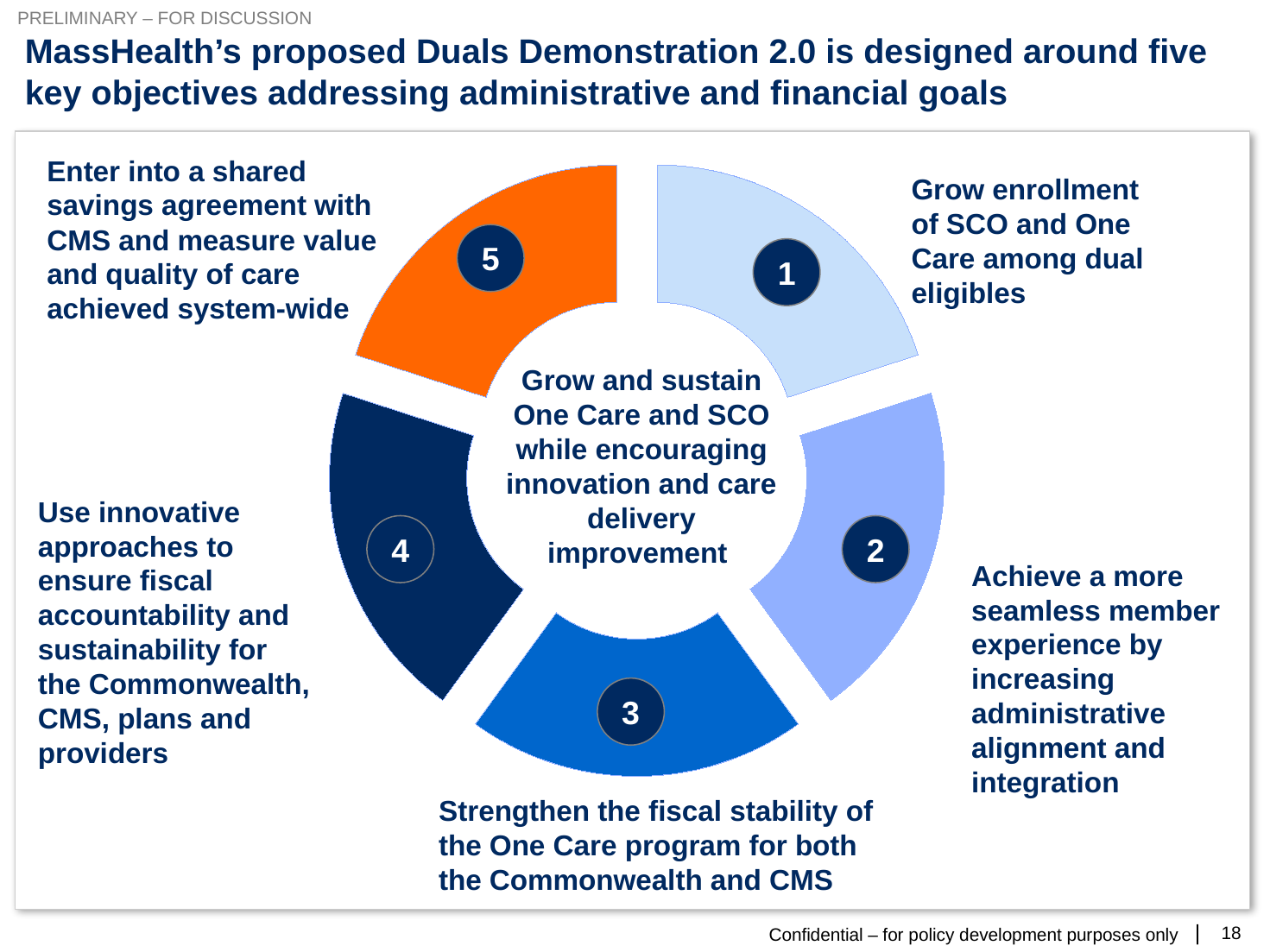
Which segment number is associated with the objective about entering into a shared savings agreement with CMS? 5 Which segment number is associated with the objective 'Use innovative approaches to ensure fiscal accountability and sustainability for the Commonwealth, CMS, plans and providers'? 4 What text appears in the center of the ring diagram? Grow and sustain One Care and SCO while encouraging innovation and care delivery improvement What objective is associated with segment 1 of the ring diagram? Grow enrollment of SCO and One Care among dual eligibles Which segment number is associated with the objective 'Achieve a more seamless member experience by increasing administrative alignment and integration'? 2 How many numbered segments does the ring diagram on the slide contain? 5 What objective is associated with segment 3 of the ring diagram? Strengthen the fiscal stability of the One Care program for both the Commonwealth and CMS Which numbered segment of the ring diagram is colored orange? 5